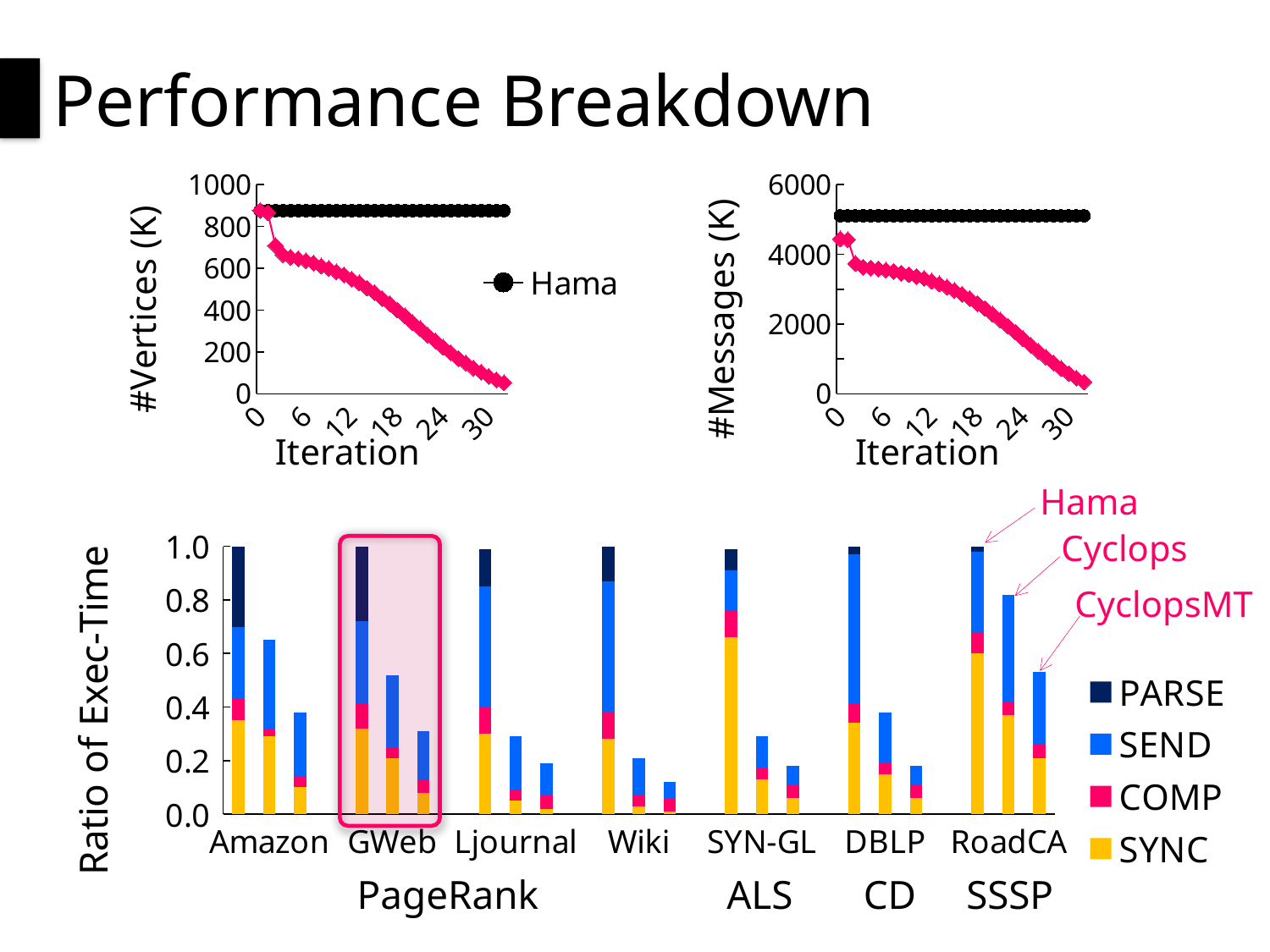
In the top-right '#Messages (K)' chart, does the black Hama line rise, fall, or stay flat across iterations? stay flat In the top-left '#Vertices (K)' chart, does the pink Cyclops line rise or fall as the iteration increases? fall In the bottom 'Ratio of Exec-Time' chart, is the total height of the CyclopsMT bar for Wiki greater or less than 0.2? less In the bottom 'Ratio of Exec-Time' chart, which of the three bars for RoadCA is the tallest? Hama How many datasets are labelled along the x axis of the bottom 'Ratio of Exec-Time' chart? 7 How many series does the legend of the bottom 'Ratio of Exec-Time' chart list? 4 In the top-right '#Messages (K)' chart, is the value of the Hama line greater or less than 4000? greater What kind of chart is the bottom chart titled 'Ratio of Exec-Time'? stacked bar chart In the bottom 'Ratio of Exec-Time' chart, what is the total height of the Hama bar for Amazon? 1.0 In the bottom 'Ratio of Exec-Time' chart, for GWeb, which bar is taller: Cyclops or CyclopsMT? Cyclops In the top-left '#Vertices (K)' chart, is the value of the Hama line greater or less than 800? greater In the bottom 'Ratio of Exec-Time' chart, which dataset is highlighted with a pink box? GWeb